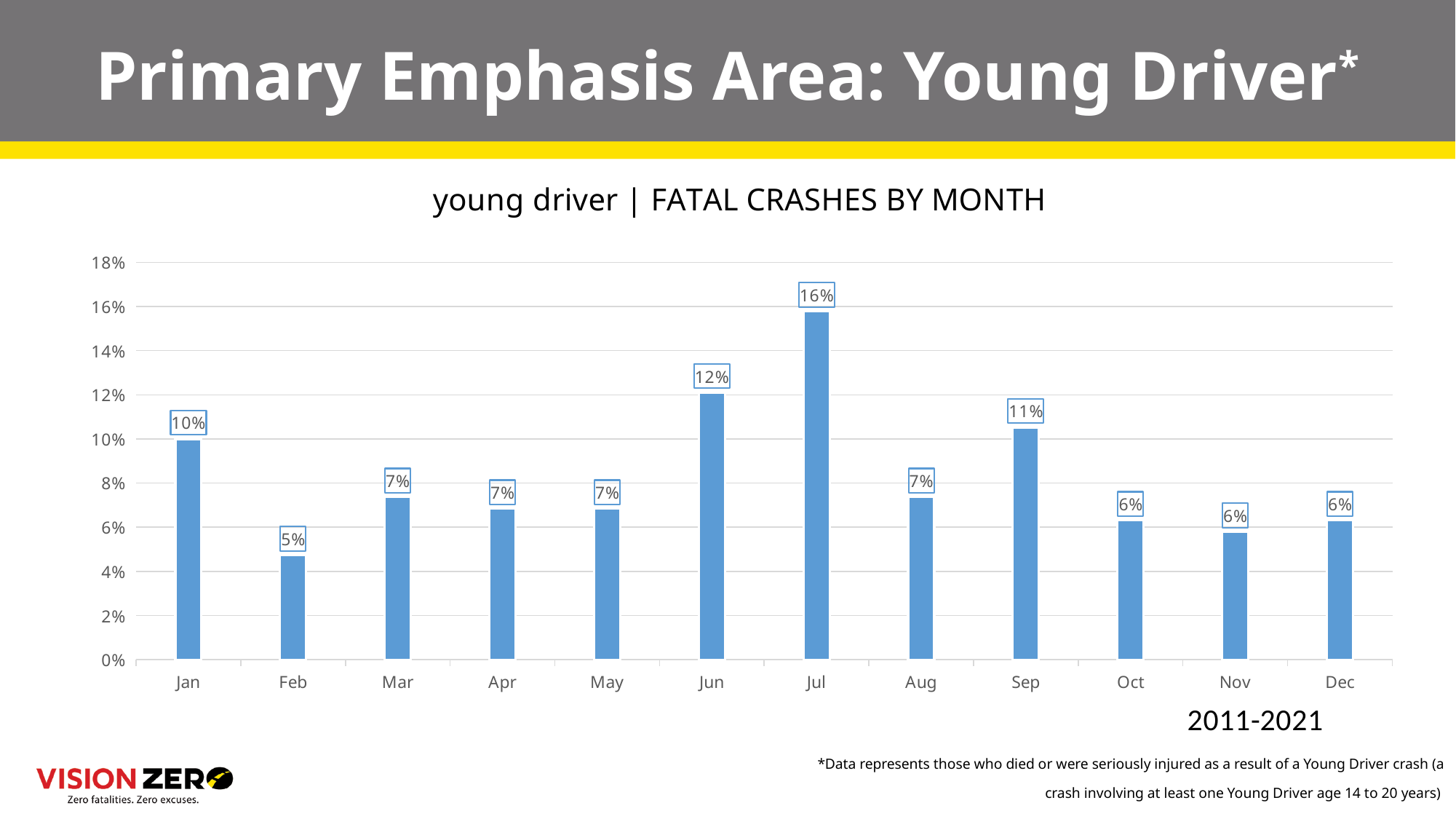
What kind of chart is shown on the slide? Bar chart Which month has a larger value, June or September? Jun What is the title of the chart? young driver | FATAL CRASHES BY MONTH What percentage is shown for September? 11% What year range does the chart cover? 2011-2021 Which month has the highest share of young driver fatal crashes? Jul What is the value shown for February? 5% What percentage of young driver fatal crashes occurred in July? 16% Which month has the lowest share of young driver fatal crashes? Feb What is the difference between the July value and the February value? 11% How many months are shown on the x axis? 12 Is the value for January greater or less than 8%? greater